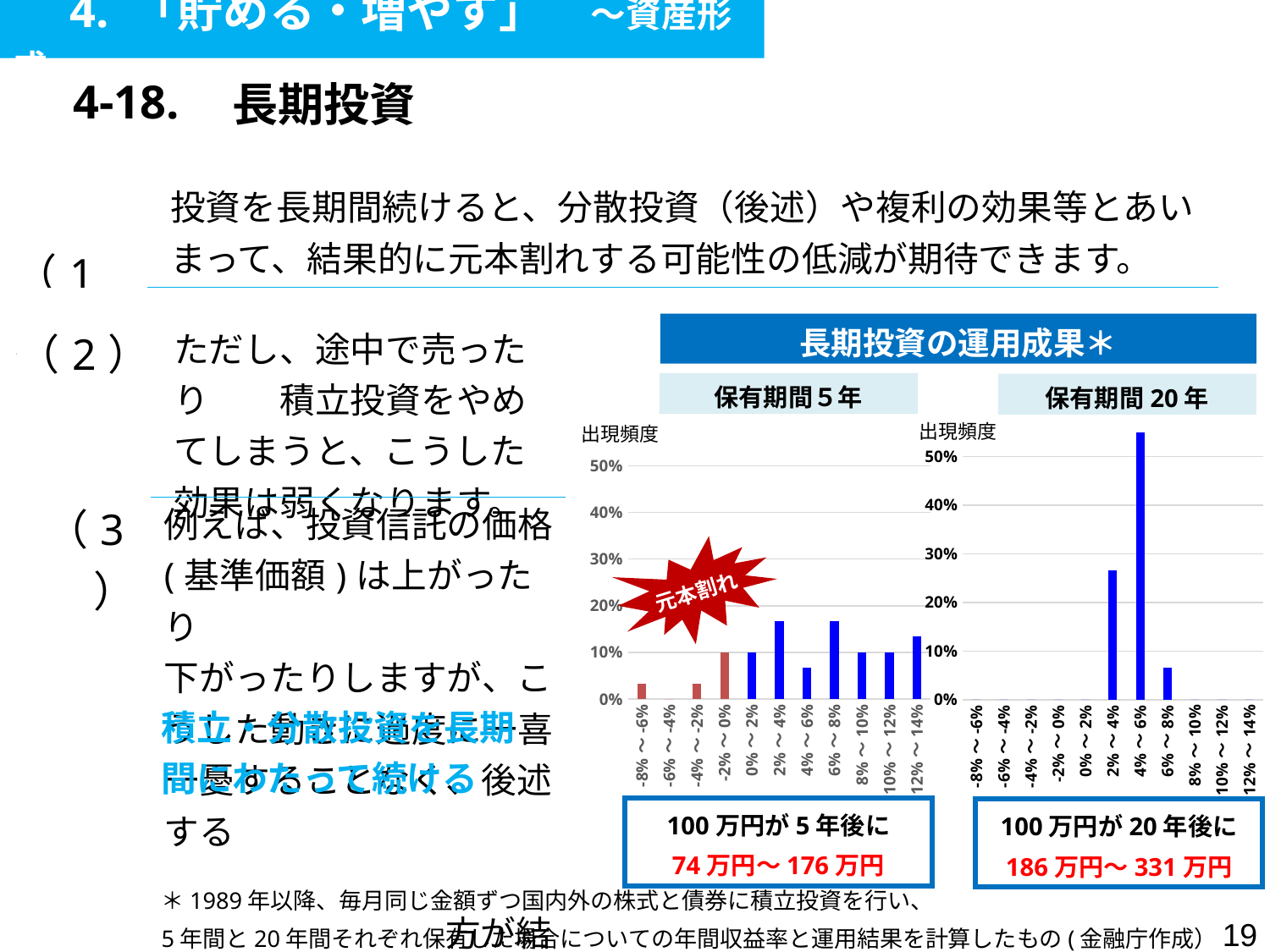
What kind of chart is used for the 保有期間５年 chart? bar chart In the 保有期間20年 chart, which category has the highest frequency? 4%～6% What is the overall title shown above the two charts? 長期投資の運用成果＊ In the 保有期間20年 chart, which is larger, the value for 2%～4% or the value for 4%～6%? 4%～6% How many return-rate categories are shown on the x axis of the 保有期間20年 chart? 11 In the 保有期間５年 chart, is the value for 2%～4% greater or less than 10%? greater In the 保有期間20年 chart, is the value for 6%～8% greater or less than 10%? less In the 保有期間20年 chart, is the value for 4%～6% greater or less than 50%? greater What label is shown in the red starburst over the red bars of the 保有期間５年 chart? 元本割れ In the 保有期間５年 chart, which is larger, the value for 2%～4% or the value for 4%～6%? 2%～4%